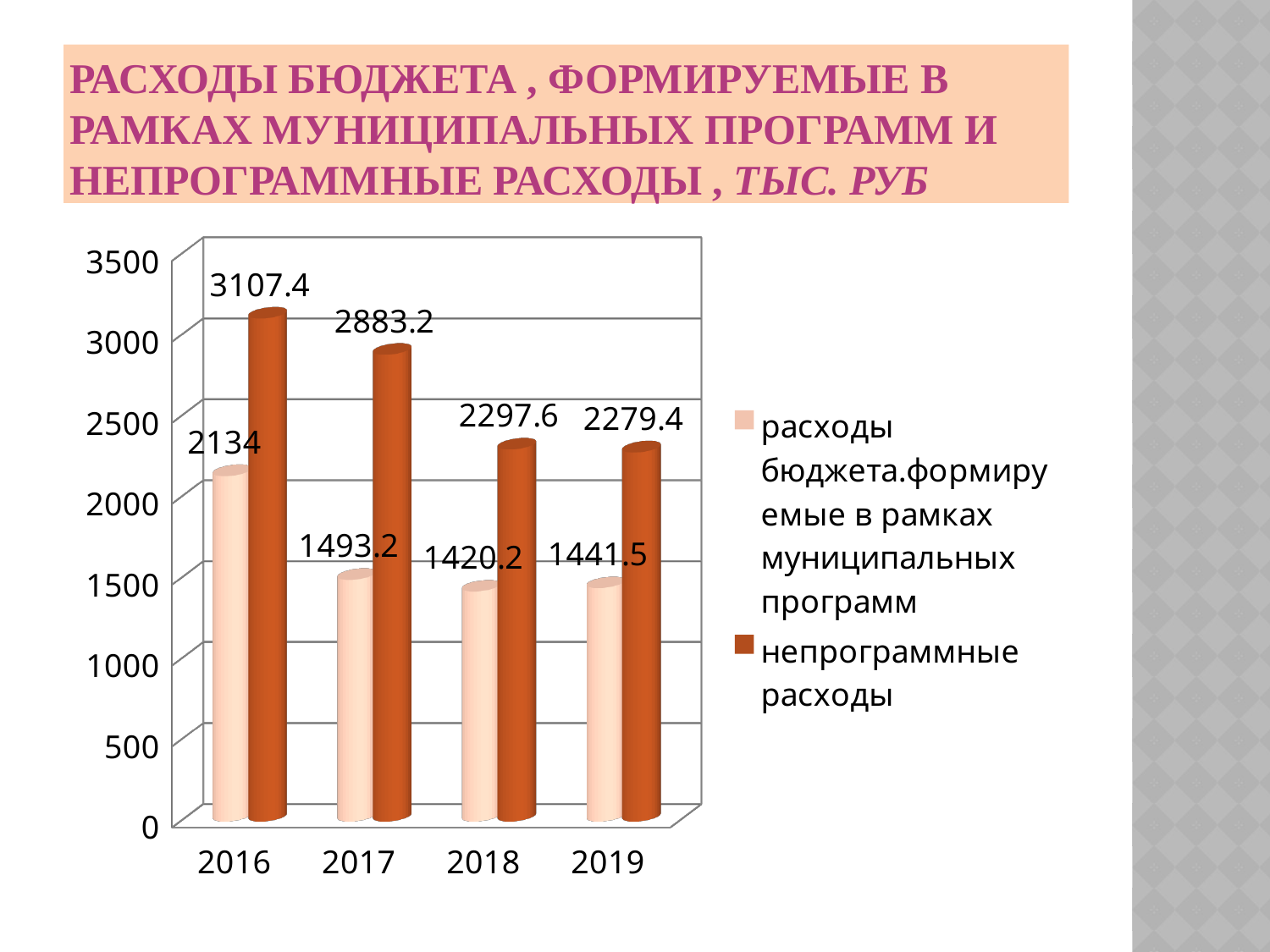
Is the value of непрограммные расходы for 2018 greater or less than 2000? greater How many series does the legend list? 2 Which is larger in 2019: непрограммные расходы or расходы бюджета, формируемые в рамках муниципальных программ? непрограммные расходы What is the value of непрограммные расходы for 2019? 2279.4 Do непрограммные расходы rise or fall from 2016 to 2019? fall How many years are shown on the x axis? 4 What is the value of расходы бюджета, формируемые в рамках муниципальных программ for 2018? 1420.2 What kind of chart is shown on the slide? bar chart In which year are непрограммные расходы the highest? 2016 What is the difference between непрограммные расходы and расходы бюджета, формируемые в рамках муниципальных программ in 2017? 1390 In which year are расходы бюджета, формируемые в рамках муниципальных программ the lowest? 2018 What is the value of непрограммные расходы for 2016? 3107.4